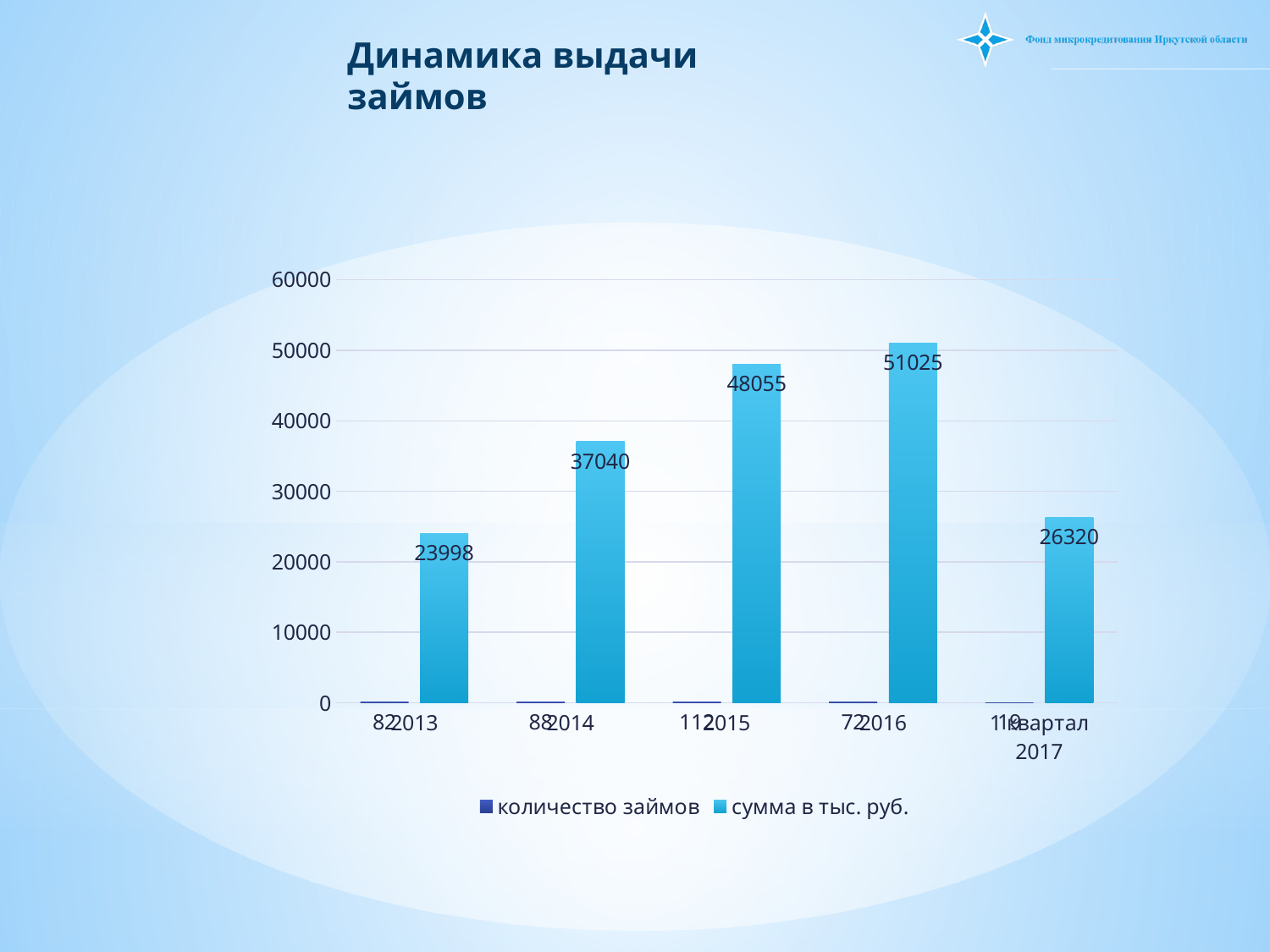
What is the value of "сумма в тыс. руб." for I квартал 2017? 26320 What is the difference between the "сумма в тыс. руб." values for 2016 and 2015? 2970 What type of chart is shown on the slide? bar chart Which is larger, the "сумма в тыс. руб." value for 2014 or for I квартал 2017? 2014 Which category has the lowest value for "сумма в тыс. руб."? 2013 How many categories are shown on the x axis? 5 How many series does the legend list? 2 What is the difference between the "сумма в тыс. руб." values for 2014 and 2013? 13042 Is the "сумма в тыс. руб." value for 2016 greater or less than 50000? greater What is the value of "сумма в тыс. руб." for 2015? 48055 What is the value of "сумма в тыс. руб." for 2013? 23998 Which category has the highest value for "сумма в тыс. руб."? 2016